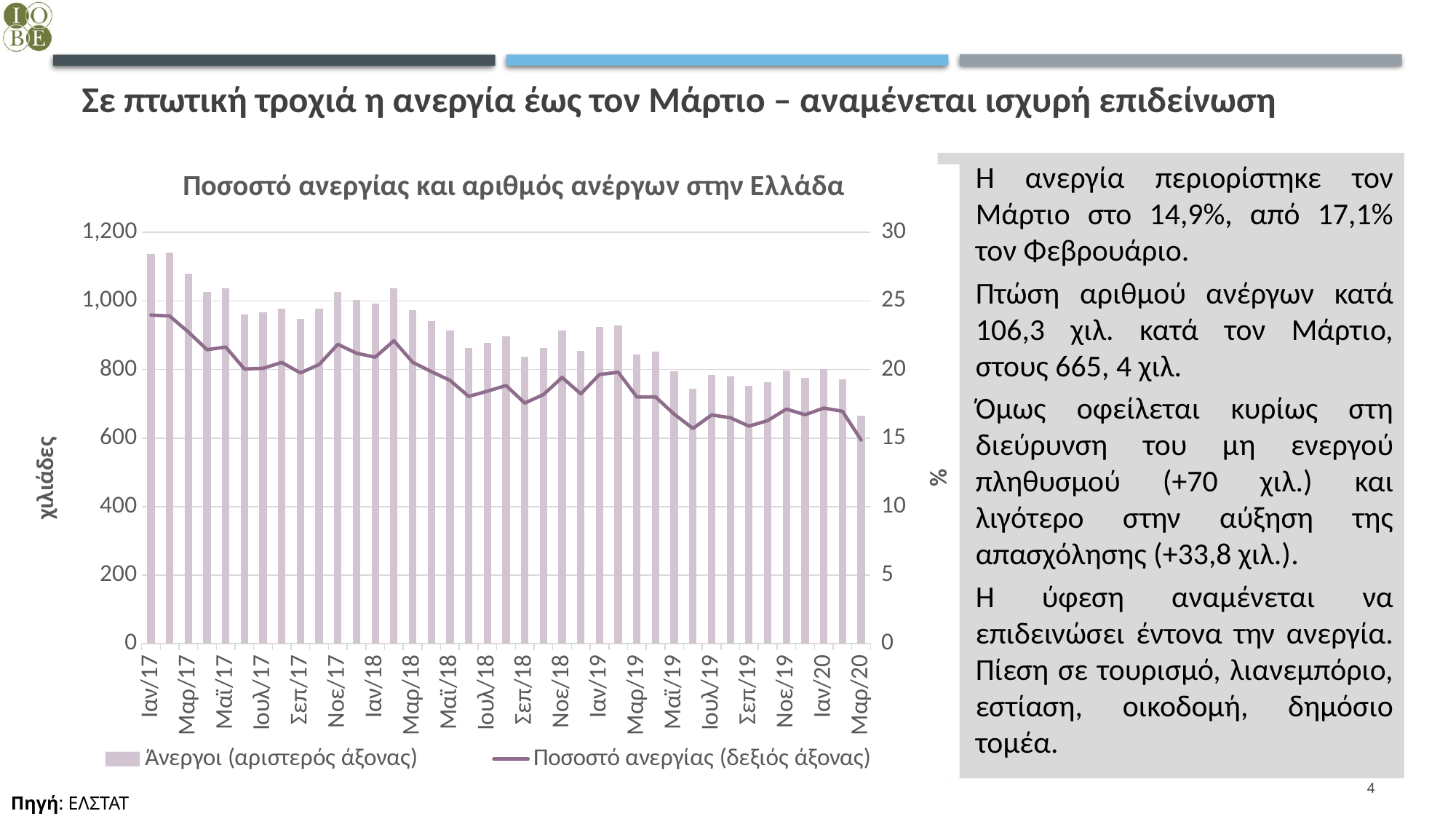
Which is larger, the number of unemployed in Ιαν/18 or in Ιαν/20? Ιαν/18 Which month has the lowest unemployment rate (line) in the chart? Μαρ/20 Does the unemployment rate line generally rise or fall from Ιαν/17 to Μαρ/20? fall Is the unemployment rate (line) for Μαρ/20 greater or less than 20%? less Is the unemployment rate (line) for Ιαν/17 greater or less than 20%? greater Is the number of unemployed (bar) for Μαρ/20 greater or less than 800 thousand? less What is the title of the chart? Ποσοστό ανεργίας και αριθμός ανέργων στην Ελλάδα How many series does the chart legend list? 2 Which series is plotted as bars according to the legend? Άνεργοι (αριστερός άξονας) What kind of chart is shown on the slide? Combined bar and line chart Which month has the lowest number of unemployed (bar) in the chart? Μαρ/20